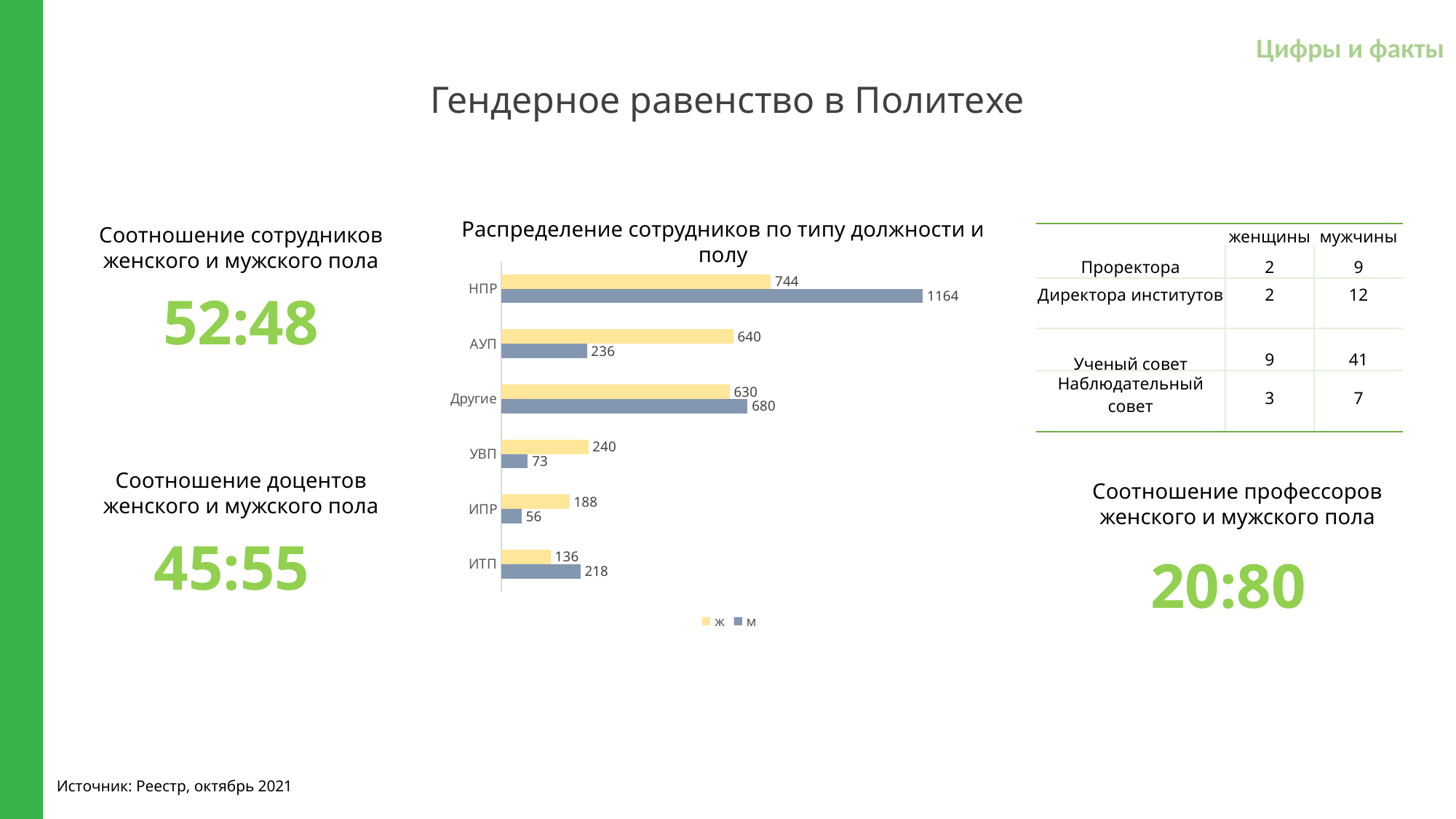
What type of chart is shown on the slide? Bar chart Which category has the highest value for м (men)? НПР How many series does the chart legend list? 2 Which category has the lowest value for м (men)? ИПР What is the difference between the м and ж values in the НПР category? 420 How many categories are shown on the chart? 6 In the УВП category, which is larger: the value for ж or the value for м? ж What is the value for м (men) in the НПР category? 1164 What is the value for ж (women) in the ИТП category? 136 What is the value for м (men) in the АУП category? 236 What is the value for ж (women) in the НПР category? 744 In the Другие category, which is larger: the value for ж or the value for м? м